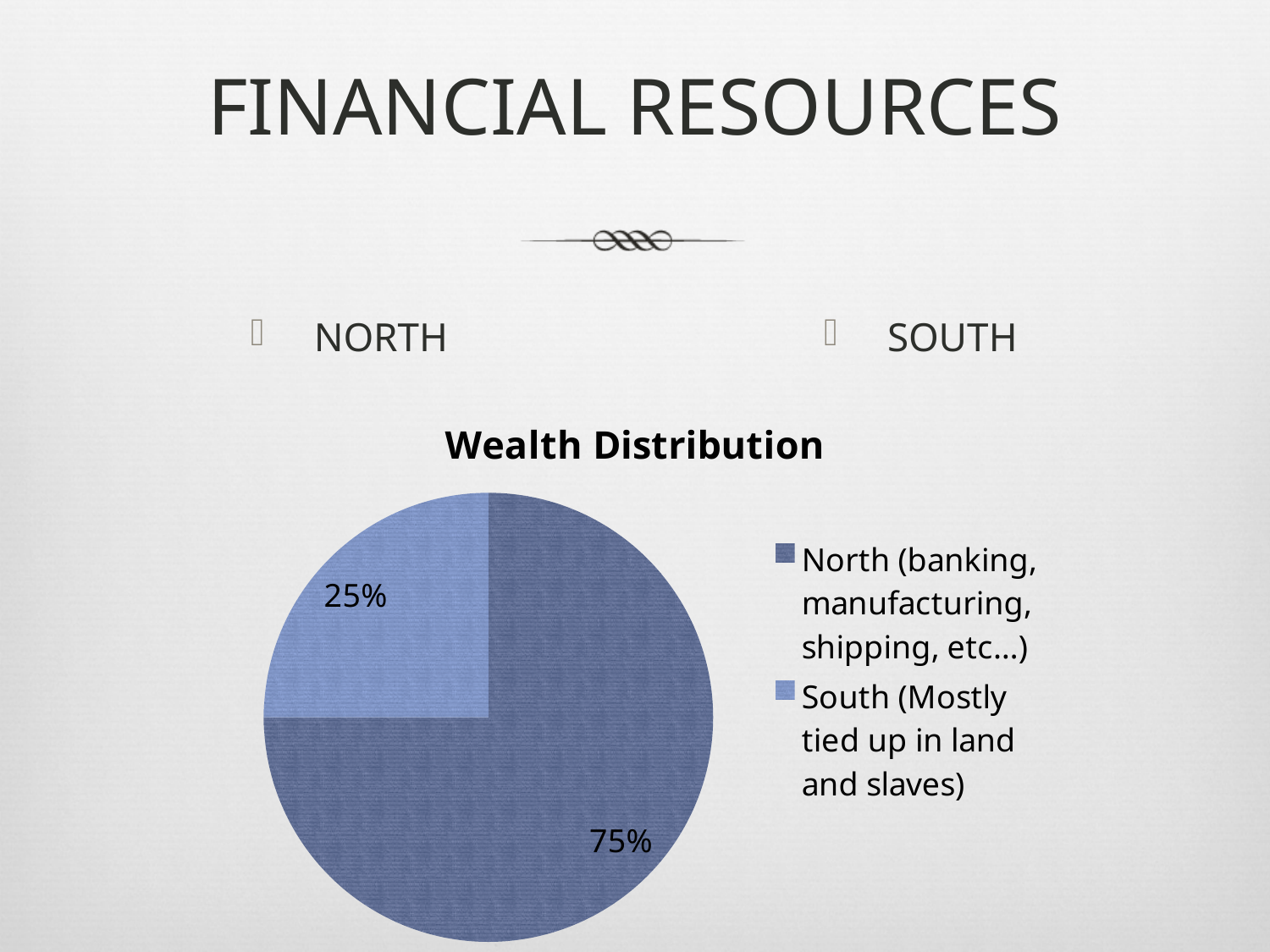
What is the difference in percentage points between the North and South slices? 50 What share of the pie does the South slice represent? 25% What share of the pie does the North slice represent? 75% What kind of chart is shown on the slide? pie chart Which slice of the pie is the smallest? South (Mostly tied up in land and slaves) How many slices does the pie chart have? 2 How many entries does the legend list? 2 Which legend entry is shown in the lighter blue colour? South (Mostly tied up in land and slaves) Which is larger, the North slice or the South slice? North Is the South slice greater or less than 50% of the pie? less What is the title of the chart? Wealth Distribution Which slice of the pie is the largest? North (banking, manufacturing, shipping, etc...)